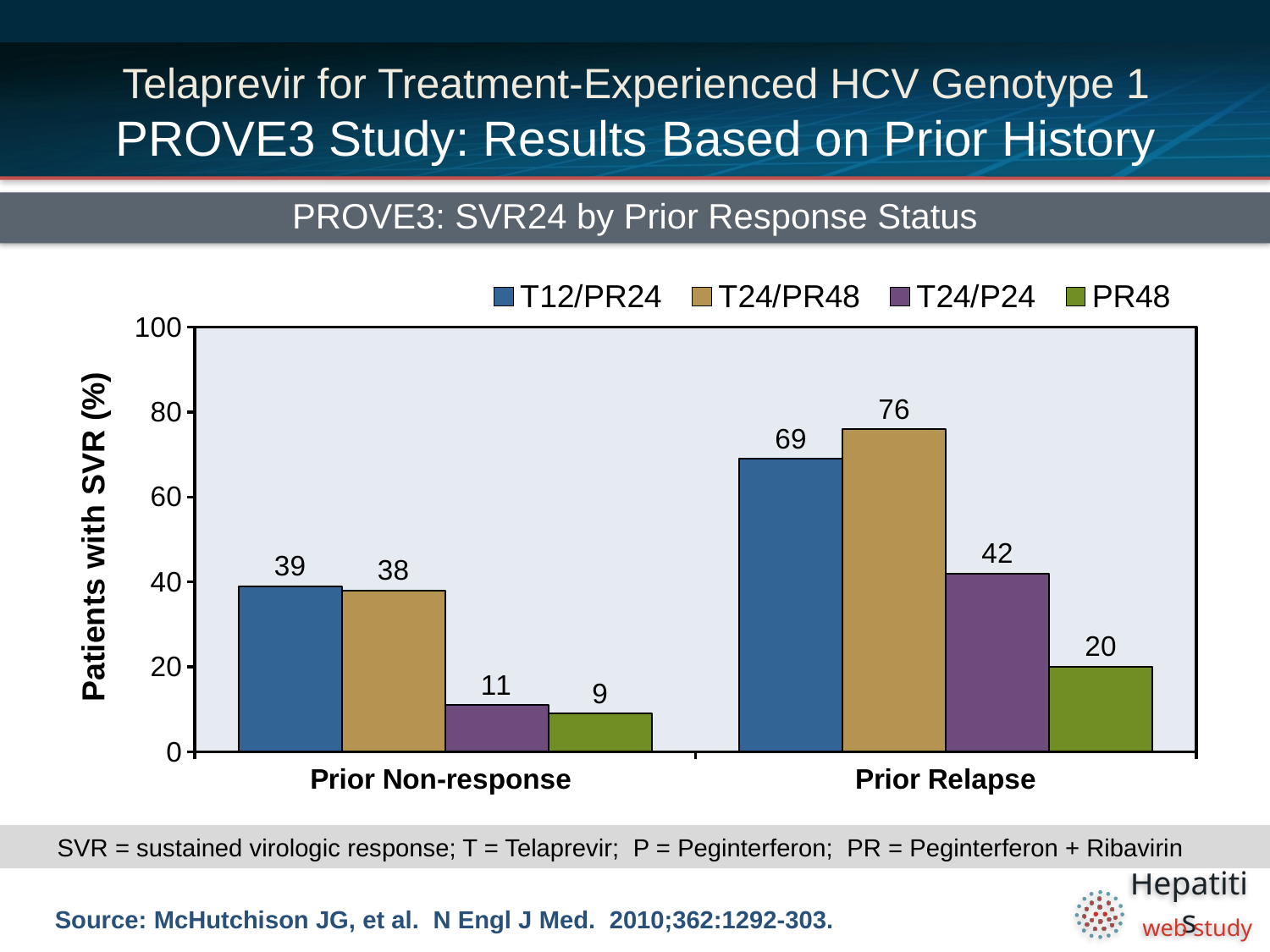
What is the SVR rate for PR48 in the Prior Relapse group? 20 Which treatment arm has the lowest SVR rate in the Prior Non-response group? PR48 What kind of chart is shown on the slide? Bar chart What is the label of the y axis? Patients with SVR (%) How many prior response status categories are shown on the x axis? 2 What is the difference between the T24/PR48 SVR rates for Prior Relapse and Prior Non-response? 38 What is the SVR rate for T24/P24 in the Prior Non-response group? 11 Is the T24/PR48 value for Prior Relapse greater or less than 60? greater How many treatment arms does the legend list? 4 Which is larger: the T12/PR24 value for Prior Relapse or the T24/P24 value for Prior Relapse? T12/PR24 for Prior Relapse What is the SVR rate for T12/PR24 in the Prior Non-response group? 39 Which treatment arm has the highest SVR rate in the Prior Relapse group? T24/PR48